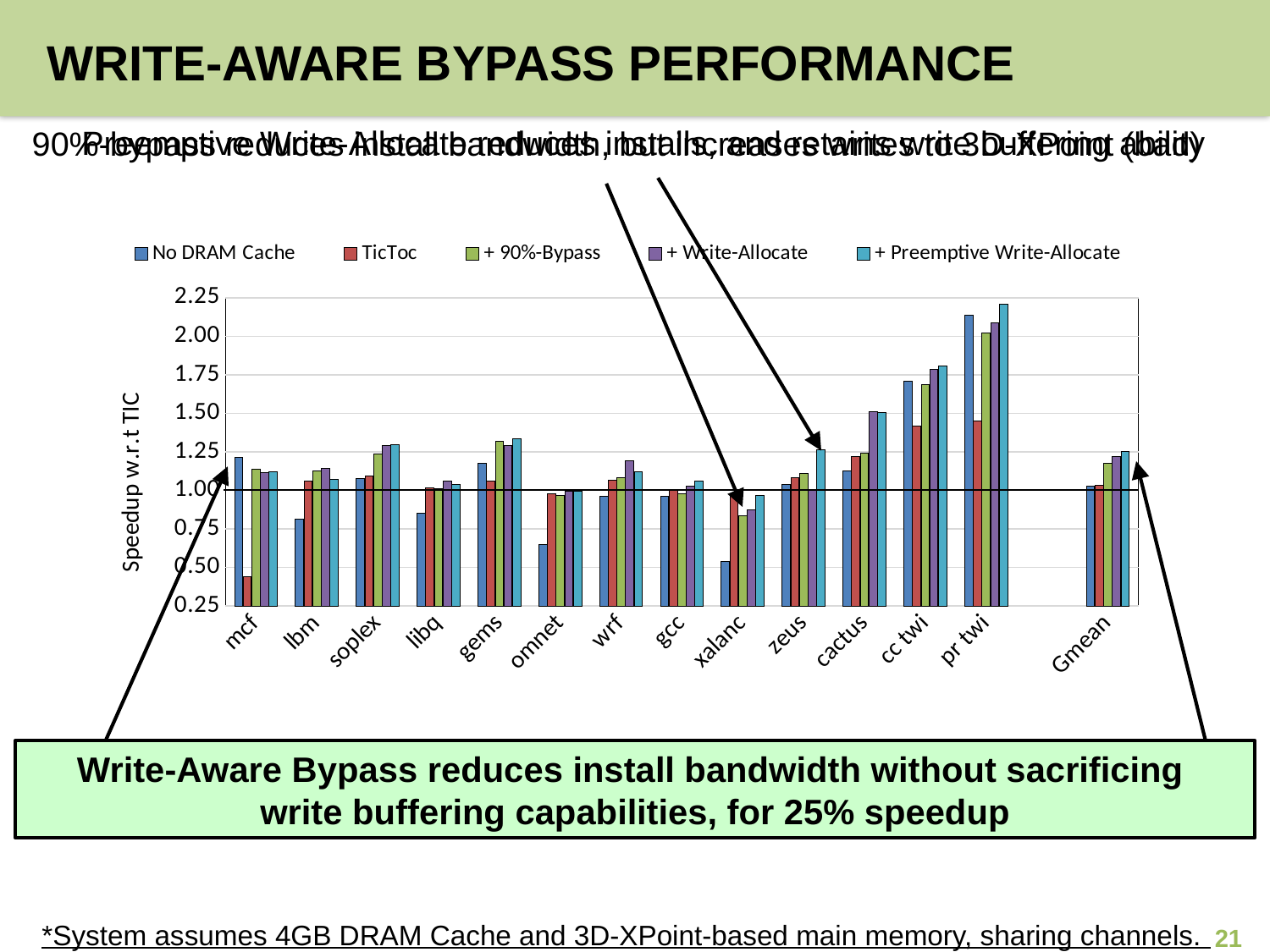
What is the title of the y axis? Speedup w.r.t TIC Is the No DRAM Cache value for cc twi greater or less than 1.50? greater Is the No DRAM Cache value for omnet greater or less than 0.75? less Which category has the highest No DRAM Cache value? pr twi What kind of chart is shown on the slide? bar chart How many series does the legend list? 5 Which category has the lowest TicToc value? mcf For pr twi, which is larger: the TicToc value or the + 90%-Bypass value? + 90%-Bypass Is the No DRAM Cache value for pr twi greater or less than 2.00? greater Which series is listed first in the legend? No DRAM Cache How many categories are shown along the x axis? 14